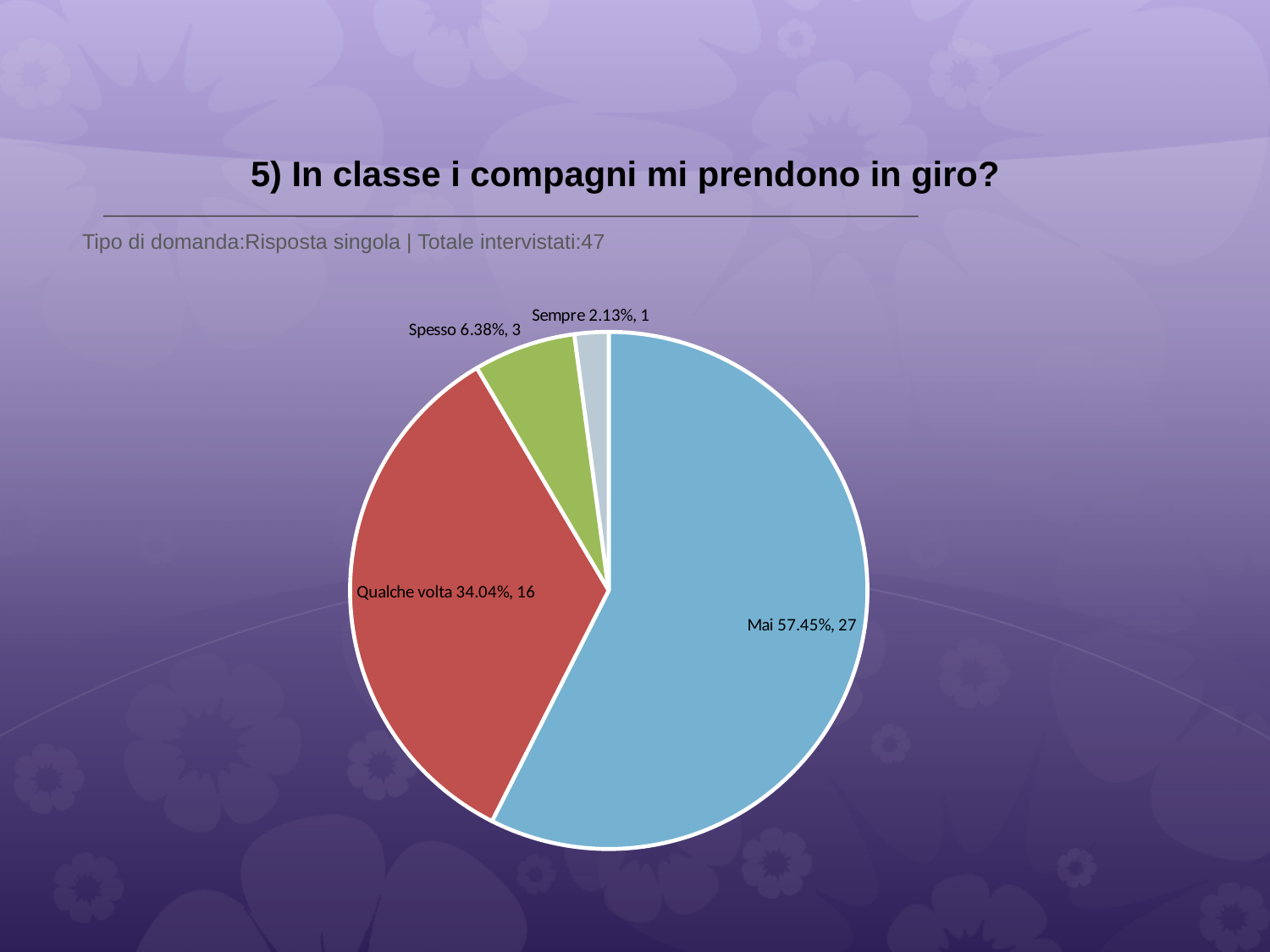
Which answer has the largest share of the pie? Mai What percentage of respondents answered "Spesso"? 6.38% How many respondents answered "Sempre"? 1 How many respondents answered "Qualche volta"? 16 Which has more respondents, "Spesso" or "Sempre"? Spesso What colour is the "Qualche volta" slice? red What percentage of respondents answered "Mai"? 57.45% What is the difference in number of respondents between "Mai" and "Qualche volta"? 11 What kind of chart is shown on the slide? pie chart Which answer has the smallest share of the pie? Sempre How many slices does the pie chart have? 4 What is the total number of respondents shown across all slices? 47